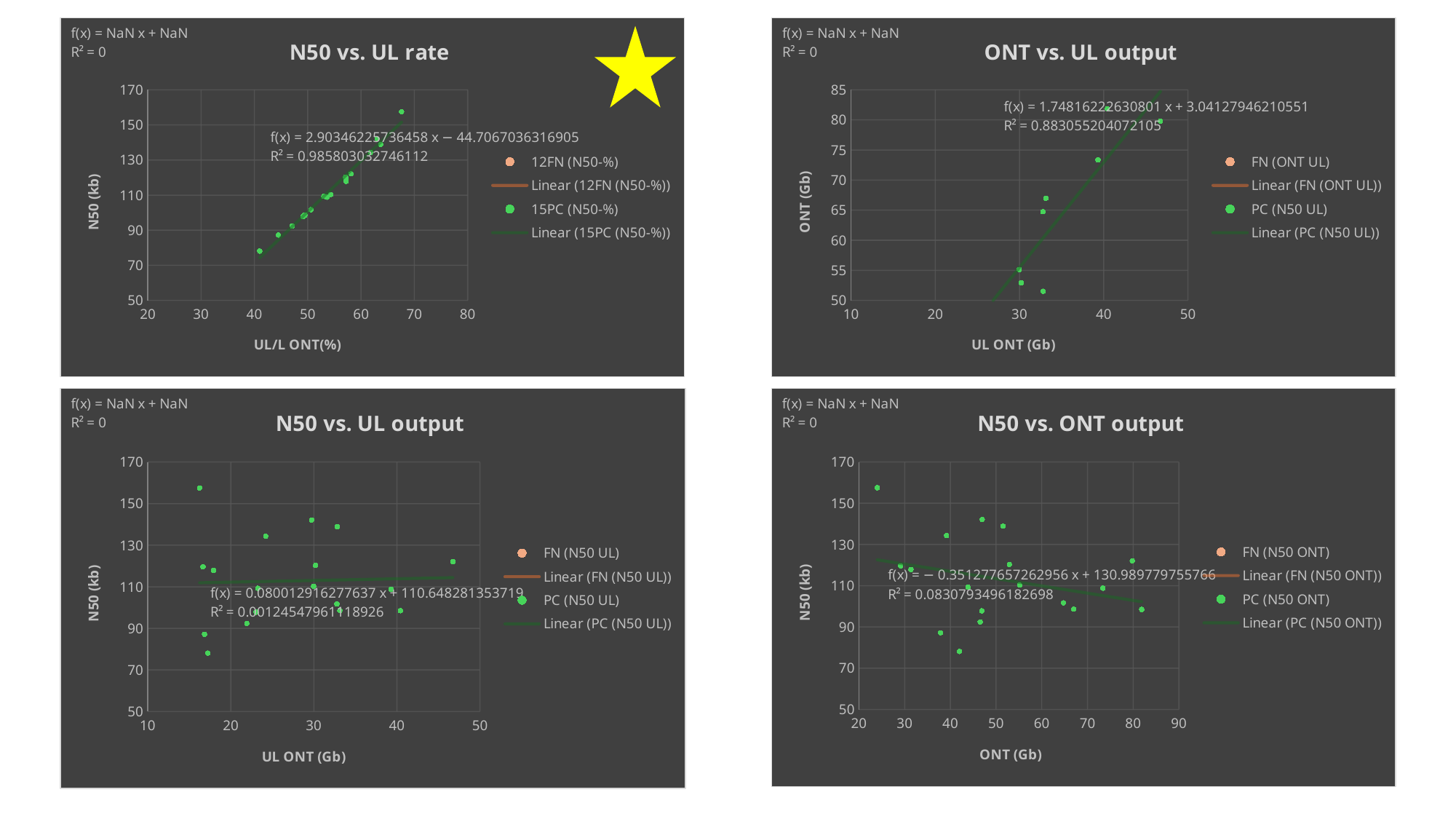
In the 'N50 vs. UL output' chart, is the highest plotted N50 value greater or less than 150? greater In the 'N50 vs. UL rate' chart, do the N50 values rise or fall as UL/L ONT(%) increases? rise In the 'N50 vs. ONT output' chart, is the lowest plotted N50 value greater or less than 90? less What R² value is printed for the 15PC trend line in the 'N50 vs. UL rate' chart? 0.985803032746112 How many entries does the legend of the 'N50 vs. UL rate' chart list? 4 What is the y-axis title of the 'ONT vs. UL output' chart? ONT (Gb) In the 'ONT vs. UL output' chart, is the highest plotted ONT value greater or less than 75? greater What kind of chart is the 'N50 vs. UL rate' chart? scatter chart What R² value is printed for the PC trend line in the 'ONT vs. UL output' chart? 0.883055204072105 What is the x-axis title of the 'N50 vs. ONT output' chart? ONT (Gb) What R² value is printed for the PC trend line in the 'N50 vs. UL output' chart? 0.00124547961118926 In the 'ONT vs. UL output' chart, do the ONT values rise or fall as UL ONT (Gb) increases? rise